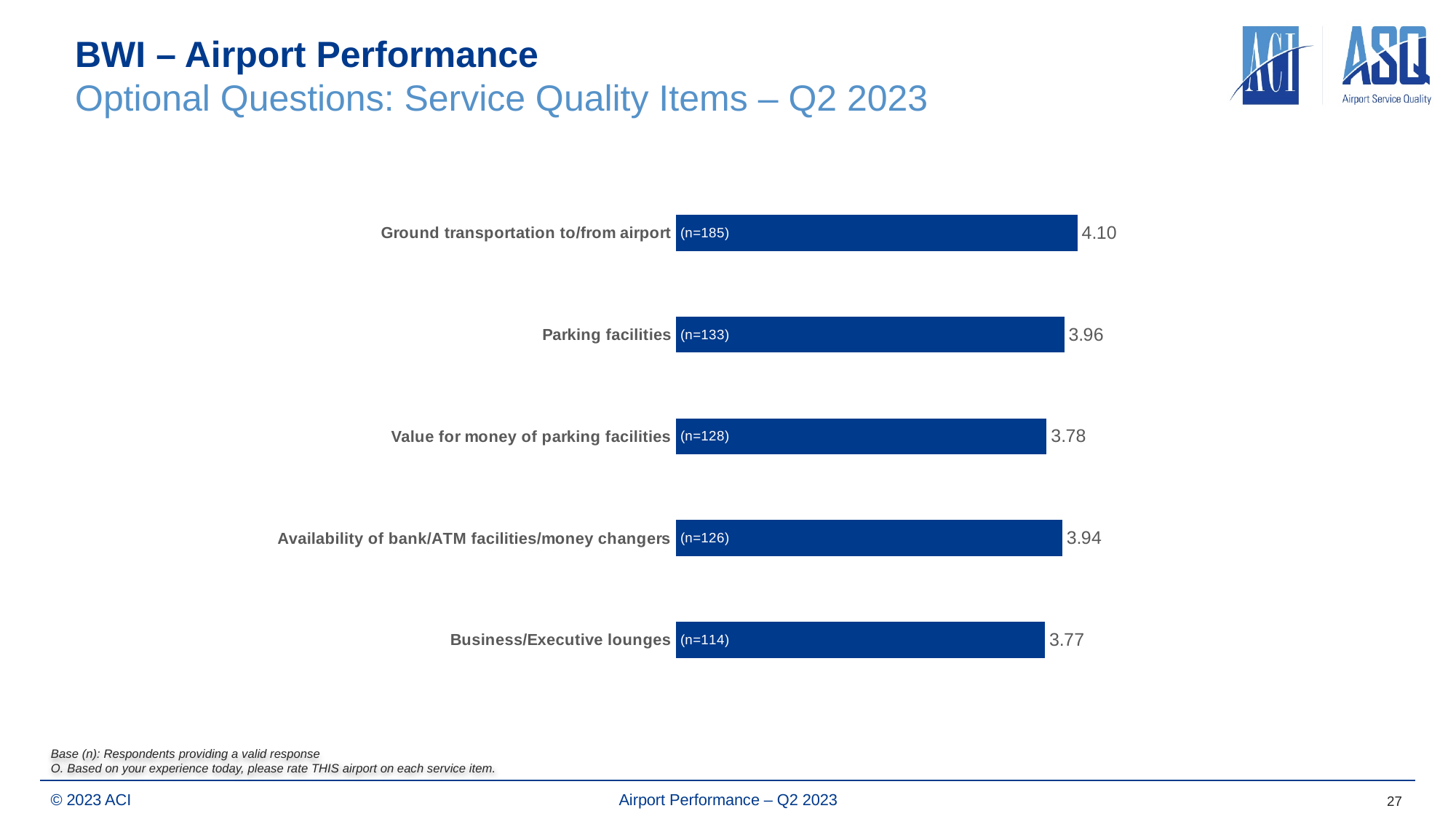
What is the rating for Ground transportation to/from airport? 4.10 Which has a higher rating, Parking facilities or Value for money of parking facilities? Parking facilities Which service quality item has the lowest rating? Business/Executive lounges What is the rating for Availability of bank/ATM facilities/money changers? 3.94 How many service quality items are shown in the chart? 5 What is the difference between the ratings for Ground transportation to/from airport and Value for money of parking facilities? 0.32 What kind of chart is shown on the slide? Bar chart How many respondents (n) provided a valid response for Ground transportation to/from airport? 185 How many respondents (n) provided a valid response for Business/Executive lounges? 114 What is the rating for Parking facilities? 3.96 Which service quality item has the highest rating? Ground transportation to/from airport What is the rating for Business/Executive lounges? 3.77